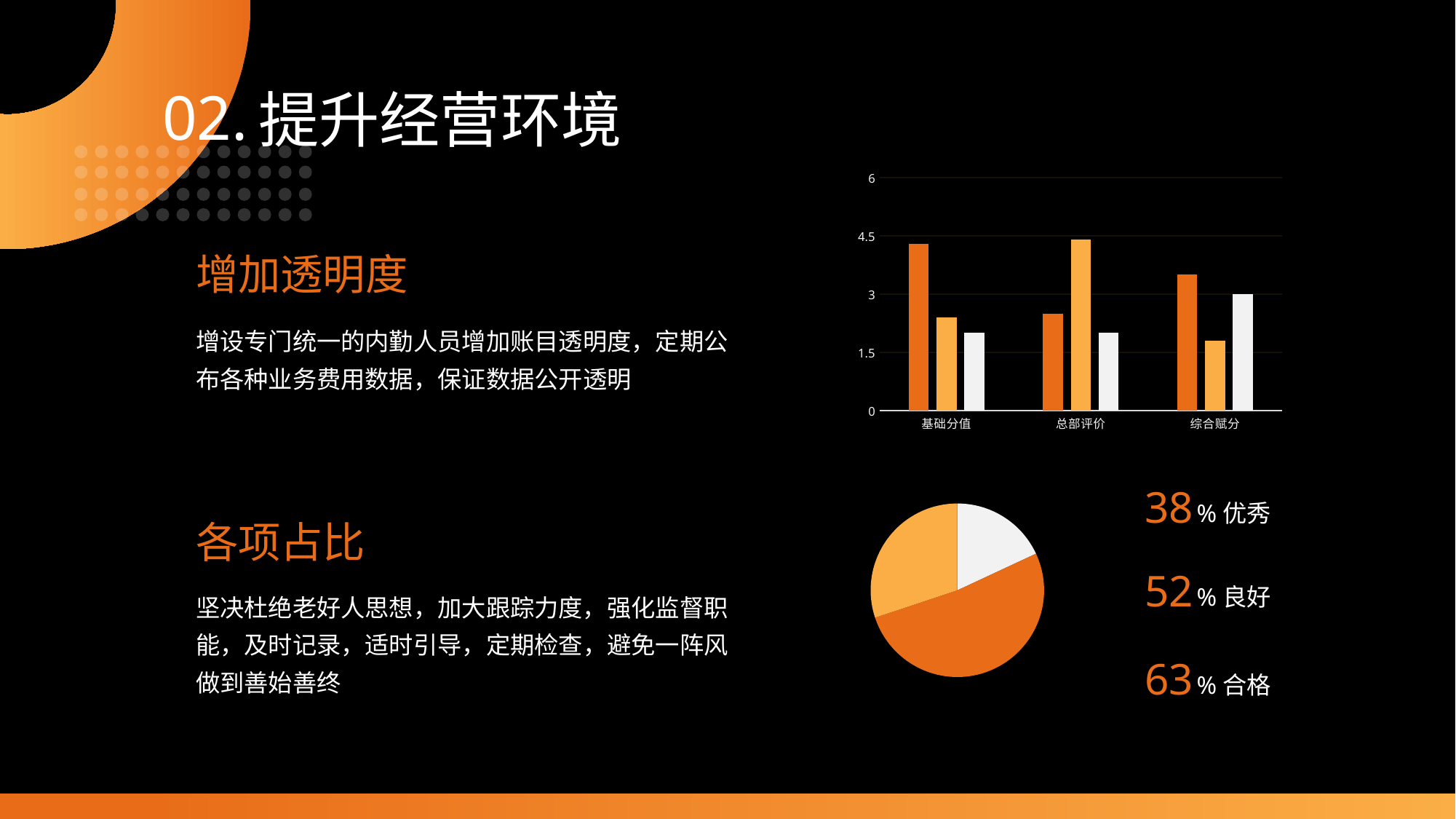
In the bar chart at the top right, for 基础分值, which is larger: the dark orange (first) bar or the white (third) bar? the dark orange (first) bar In the bar chart at the top right, is the value of the dark orange (first) bar for 基础分值 greater or less than 3? greater In the bar chart at the top right, is the value of the dark orange (first) bar for 综合赋分 greater or less than 3? greater In the bar chart at the top right, which bar is the shortest for the category 基础分值? the white (third) bar How many slices does the pie chart at the bottom right have? 3 In the bar chart at the top right, which bar is the tallest for the category 总部评价? the light orange (middle) bar In the bar chart at the top right, is the value of the white (third) bar for 基础分值 greater or less than 3? less How many categories are shown on the x axis of the bar chart at the top right? 3 What type of chart is the chart at the bottom right of the slide? pie chart What type of chart is the chart at the top right of the slide? bar chart In the pie chart at the bottom right, which colour slice is the largest? dark orange